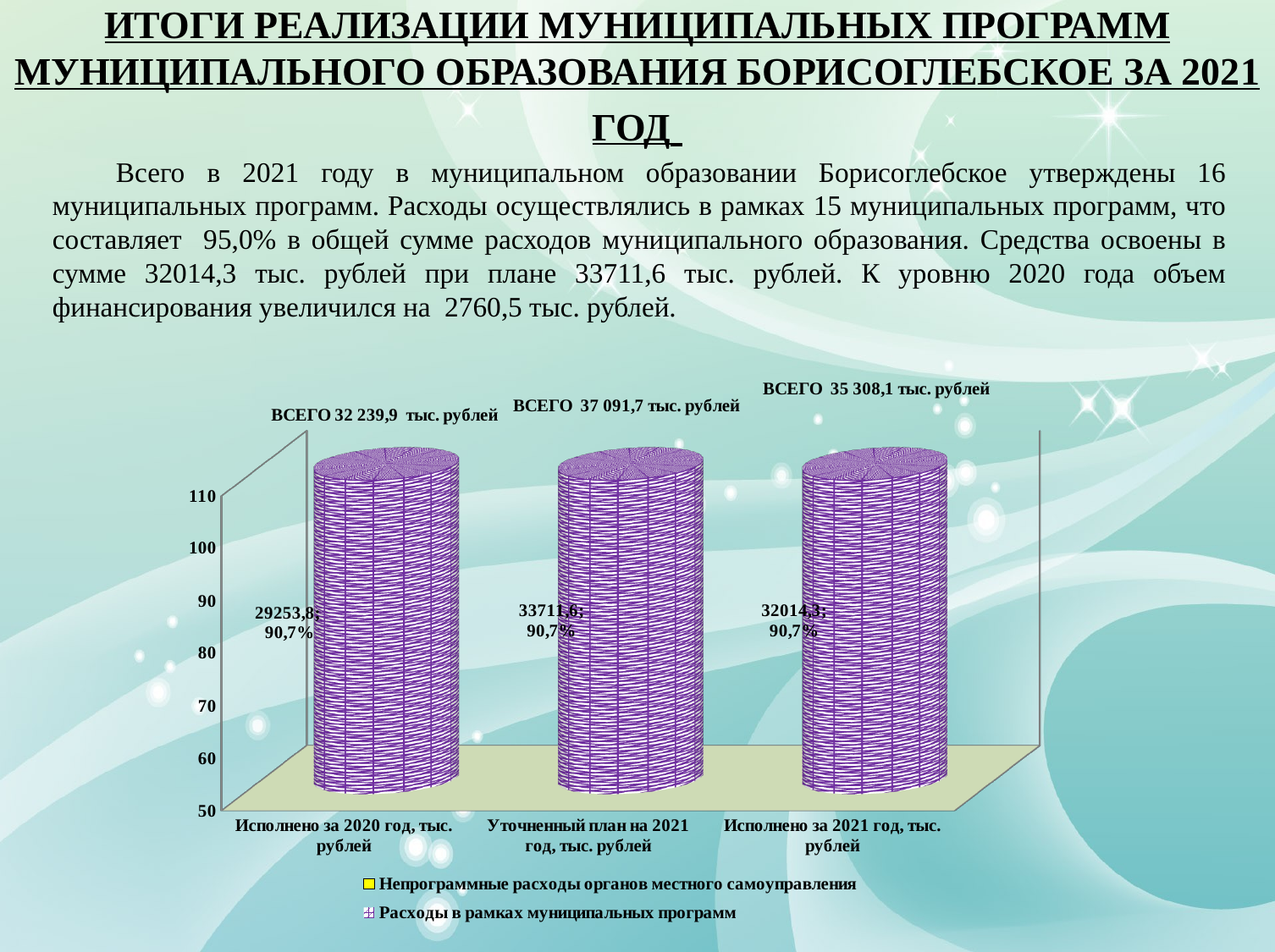
What total (ВСЕГО) is printed above the bar for "Уточненный план на 2021 год, тыс. рублей"? 37 091,7 тыс. рублей What value is labelled on the bar for "Исполнено за 2020 год, тыс. рублей"? 29253,8; 90,7% How many categories are shown on the x axis of the chart? 3 What kind of chart is shown on the slide? bar chart What value is labelled on the bar for "Исполнено за 2021 год, тыс. рублей"? 32014,3; 90,7% What total (ВСЕГО) is printed above the bar for "Исполнено за 2021 год, тыс. рублей"? 35 308,1 тыс. рублей What value is labelled on the bar for "Уточненный план на 2021 год, тыс. рублей"? 33711,6; 90,7% What is the name of the second series listed in the chart legend? Расходы в рамках муниципальных программ How many series does the chart legend list? 2 Which is larger: the programme expenditure labelled for "Уточненный план на 2021 год" or for "Исполнено за 2021 год"? Уточненный план на 2021 год What total (ВСЕГО) is printed above the bar for "Исполнено за 2020 год, тыс. рублей"? 32 239,9 тыс. рублей What is the difference between the programme expenditure labelled for "Исполнено за 2021 год" (32014,3) and for "Исполнено за 2020 год" (29253,8)? 2760,5